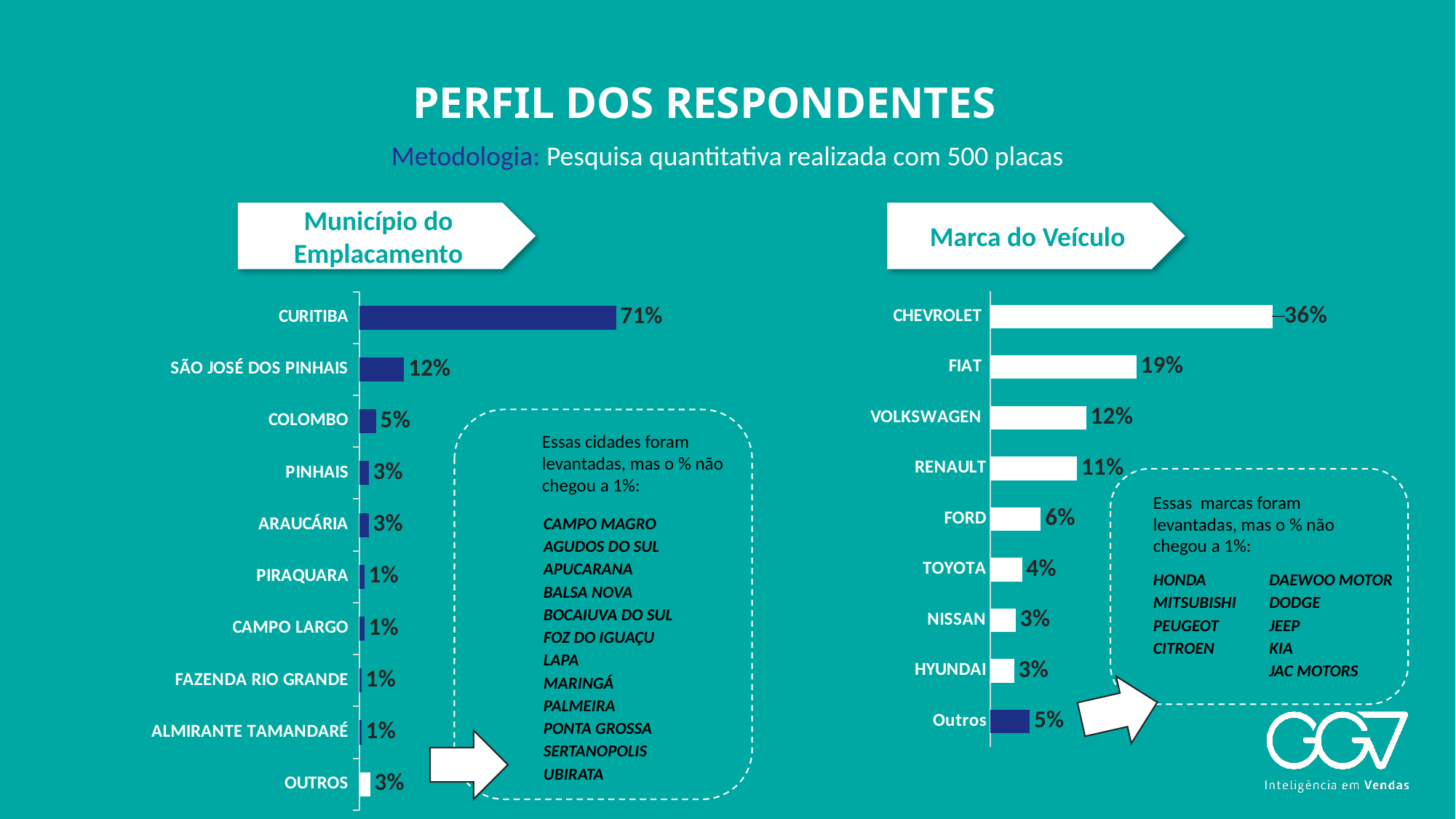
In the 'Município do Emplacamento' chart, what is the difference between Curitiba and São José dos Pinhais? 59% In the 'Marca do Veículo' chart, how many categories are shown? 9 In the 'Marca do Veículo' chart, what is the value for Renault? 11% In the 'Município do Emplacamento' chart, how many categories are shown? 10 In the 'Município do Emplacamento' chart, which municipality has the highest value? Curitiba In the 'Marca do Veículo' chart, what is the difference between Chevrolet and Fiat? 17% In the 'Marca do Veículo' chart, what is the value for Chevrolet? 36% In the 'Marca do Veículo' chart, which is larger, Fiat or Volkswagen? Fiat In the 'Município do Emplacamento' chart, what is the value for São José dos Pinhais? 12% In the 'Município do Emplacamento' chart, what is the value for Curitiba? 71% What type of chart is the 'Marca do Veículo' chart? Bar chart In the 'Marca do Veículo' chart, which brand has the highest value? Chevrolet